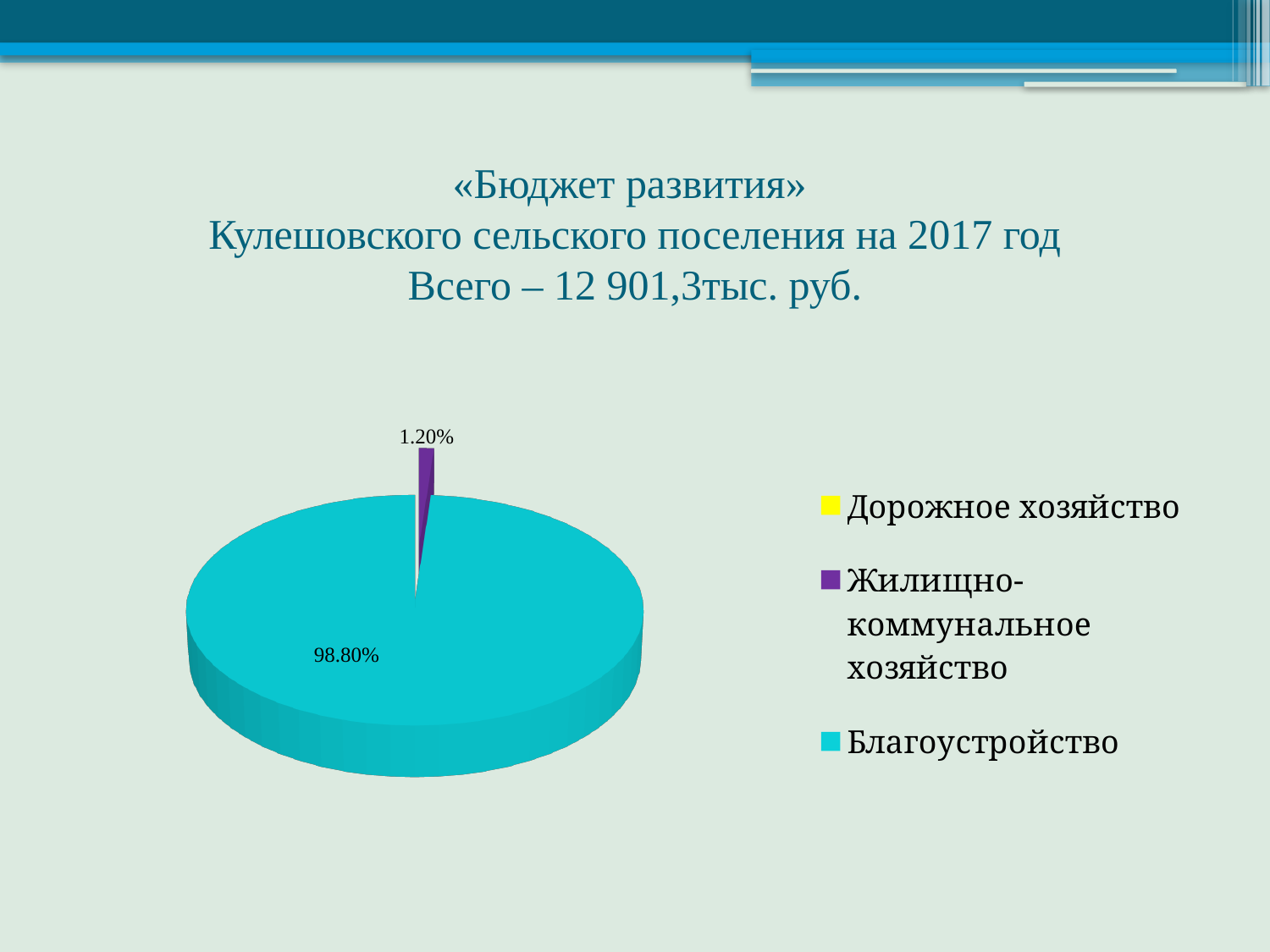
What kind of chart is shown on the slide? pie chart For which year is the «Бюджет развития» shown? 2017 What total amount is stated in the chart title? 12 901,3тыс. руб. What is the difference between the labelled shares of Благоустройство and Жилищно-коммунальное хозяйство? 97.60% Which colour represents Жилищно-коммунальное хозяйство in the legend? purple How many entries does the legend of the pie chart list? 3 Which is larger in the pie chart: Благоустройство or Жилищно-коммунальное хозяйство? Благоустройство Which category has the largest slice in the pie chart? Благоустройство What share of the pie chart is labelled for Жилищно-коммунальное хозяйство? 1.20% What share of the pie chart is labelled for Благоустройство? 98.80% Is the share for Благоустройство greater or less than 50%? greater